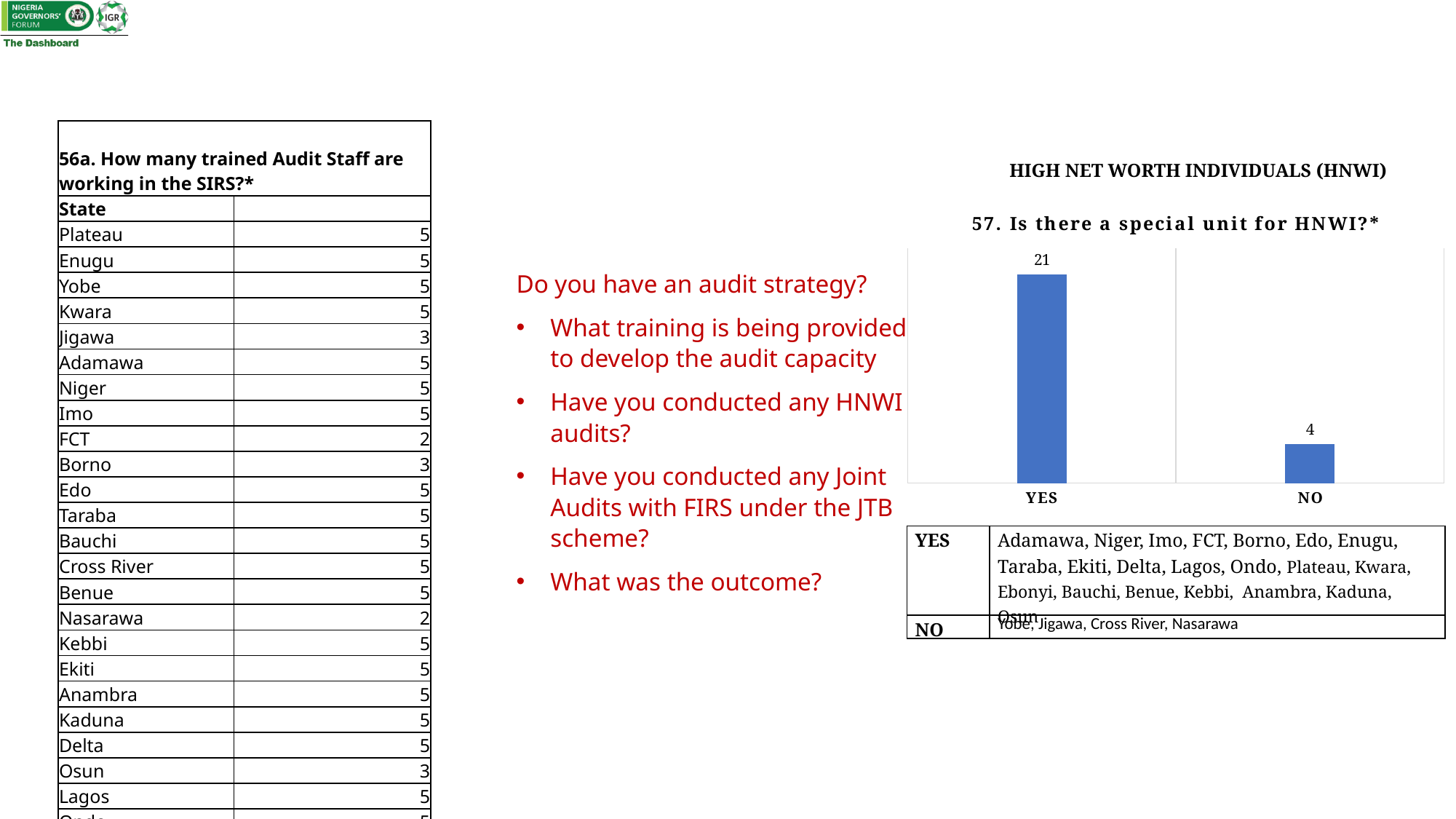
What colour are the bars in the chart '57. Is there a special unit for HNWI?'? blue What is the total of the YES and NO values in the chart '57. Is there a special unit for HNWI?'? 25 What is the difference between the YES and NO values in the chart '57. Is there a special unit for HNWI?'? 17 How many categories are shown in the chart '57. Is there a special unit for HNWI?'? 2 What kind of chart is '57. Is there a special unit for HNWI?'? bar chart What is the value for NO in the chart '57. Is there a special unit for HNWI?'? 4 What is the title of the bar chart on the slide? 57. Is there a special unit for HNWI?* Which category has the highest value in the chart '57. Is there a special unit for HNWI?'? YES Which category has the lowest value in the chart '57. Is there a special unit for HNWI?'? NO In the chart '57. Is there a special unit for HNWI?', which is larger, YES or NO? YES What is the value for YES in the chart '57. Is there a special unit for HNWI?'? 21